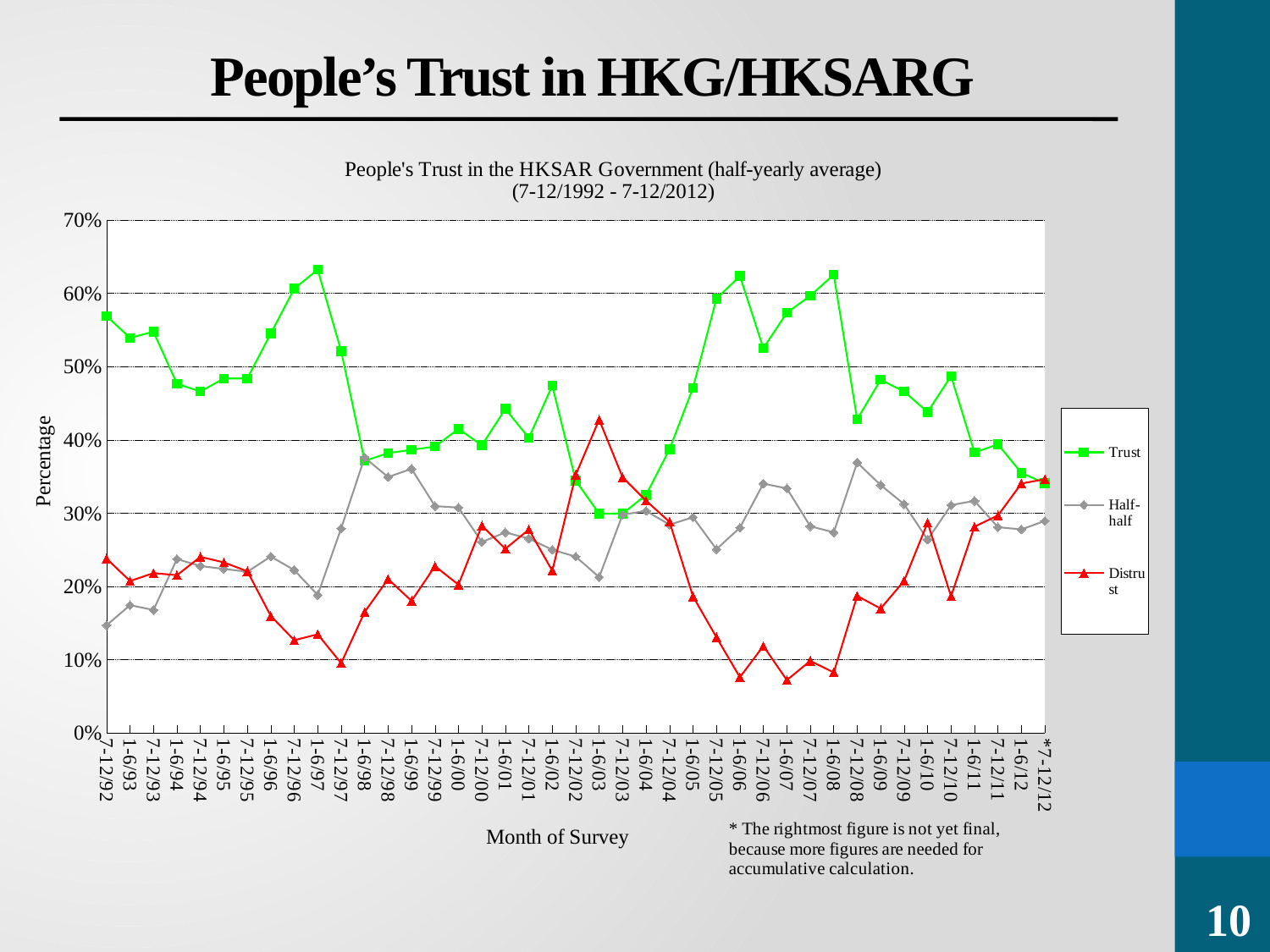
What kind of chart is shown on the slide? line chart At 1-6/03, which is larger: Trust or Distrust? Distrust Is the value for Distrust at 1-6/06 greater or less than 10%? less What are the three series named in the legend? Trust, Half-half, Distrust Which series has the lowest value at 1-6/06? Distrust What is the title of the y axis? Percentage Is the value for Trust at 1-6/98 greater or less than 40%? less How many series does the legend list? 3 Is the value for Distrust at 1-6/03 greater or less than 40%? greater At 7-12/92, which is larger: Trust or Distrust? Trust